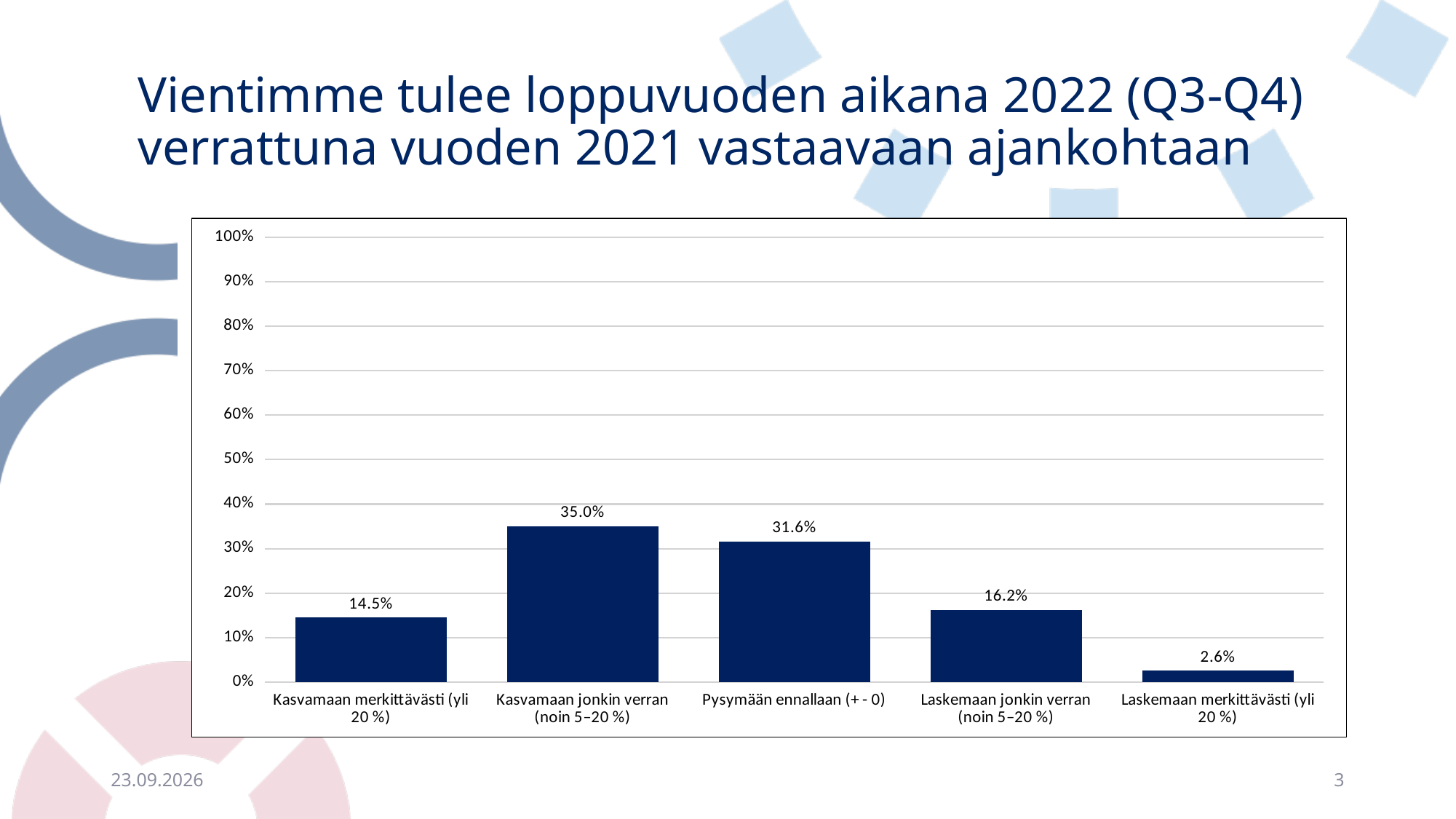
Is the value for "Pysymään ennallaan (+ - 0)" greater or less than 30%? greater What is the highest value shown on the y axis? 100% Which category has the lowest value? Laskemaan merkittävästi (yli 20 %) What is the difference between the values for "Kasvamaan jonkin verran (noin 5–20 %)" and "Pysymään ennallaan (+ - 0)"? 3.4% What is the value for "Laskemaan merkittävästi (yli 20 %)"? 2.6% What is the value for "Kasvamaan jonkin verran (noin 5–20 %)"? 35.0% Which is larger: the value for "Kasvamaan merkittävästi (yli 20 %)" or "Laskemaan jonkin verran (noin 5–20 %)"? Laskemaan jonkin verran (noin 5–20 %) What is the value for "Pysymään ennallaan (+ - 0)"? 31.6% How many categories are shown on the x axis? 5 What is the difference between the values for "Laskemaan jonkin verran (noin 5–20 %)" and "Kasvamaan merkittävästi (yli 20 %)"? 1.7% What kind of chart is shown on the slide? bar chart Which category has the highest value? Kasvamaan jonkin verran (noin 5–20 %)